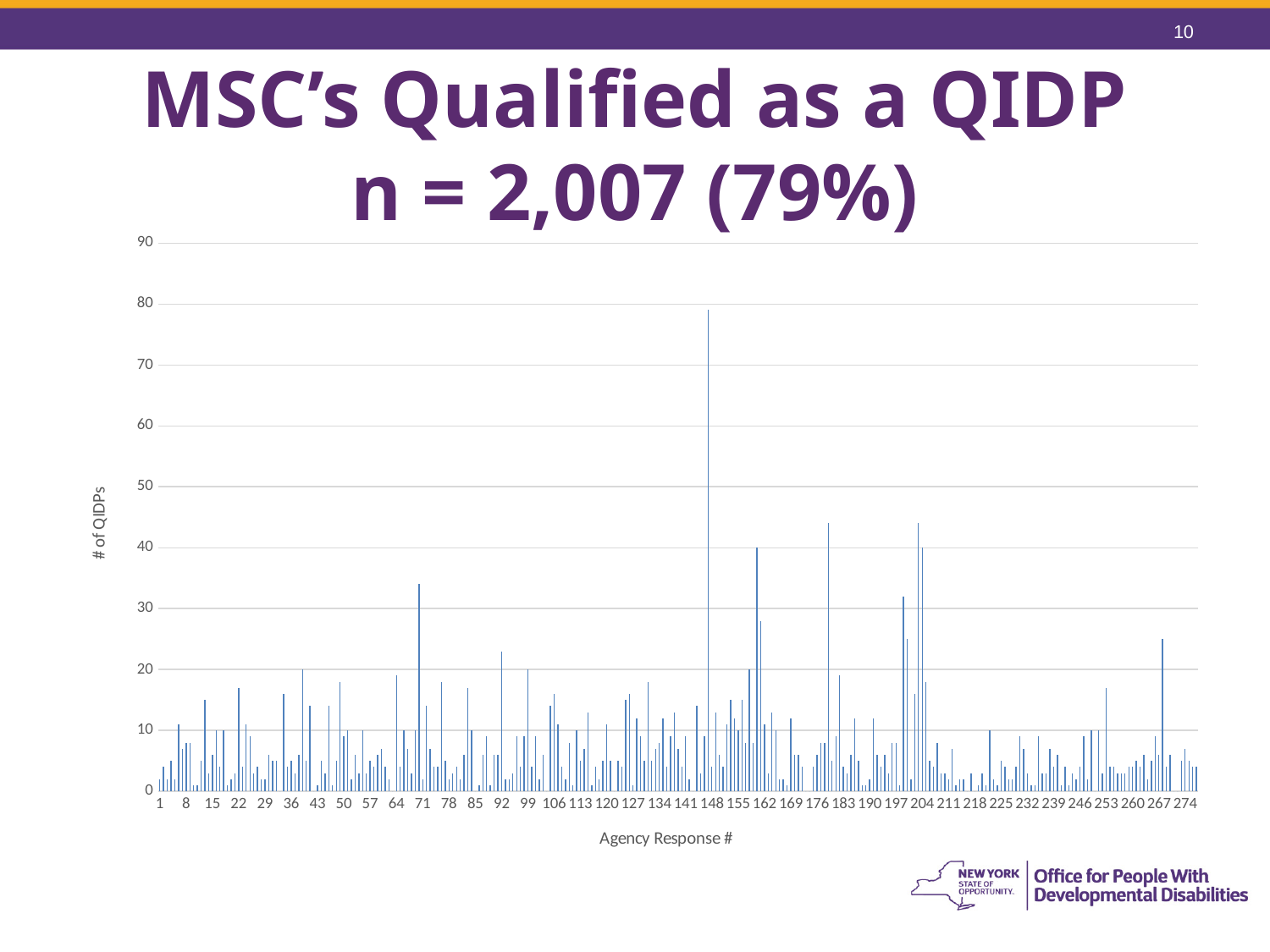
What is the label on the vertical axis of the chart? # of QIDPs What is the label on the horizontal axis of the chart? Agency Response # Is the highest value plotted on the chart greater or less than 50? greater Is the highest value plotted on the chart greater or less than 70? greater What kind of chart is shown on the slide? bar chart Are the majority of the plotted values greater or less than 20? less